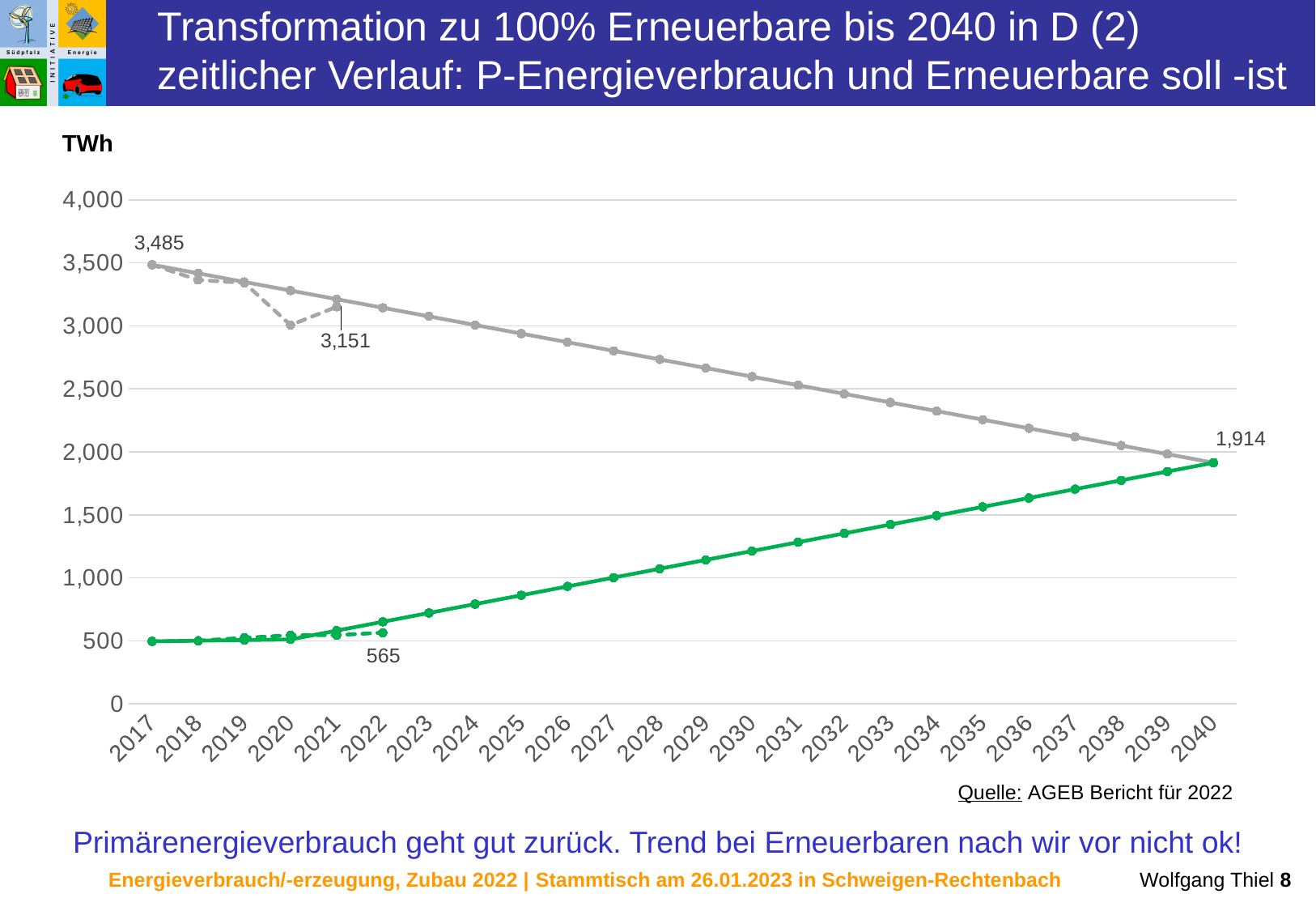
Does the green line rise or fall from 2017 to 2040? rise Is the value of the grey line in 2035 greater or less than 2,500? less Does the grey line rise or fall from 2017 to 2040? fall What unit is shown on the y axis of the chart? TWh What is the labelled value of the dashed green line in 2022? 565 What value do the grey and green lines meet at in 2040? 1,914 What is the value of the grey line (Primärenergieverbrauch) in 2017? 3,485 By how much does the grey line fall from its 2017 value (3,485) to its 2040 value (1,914)? 1,571 How many years are shown on the x axis? 24 What kind of chart is shown on the slide? line chart